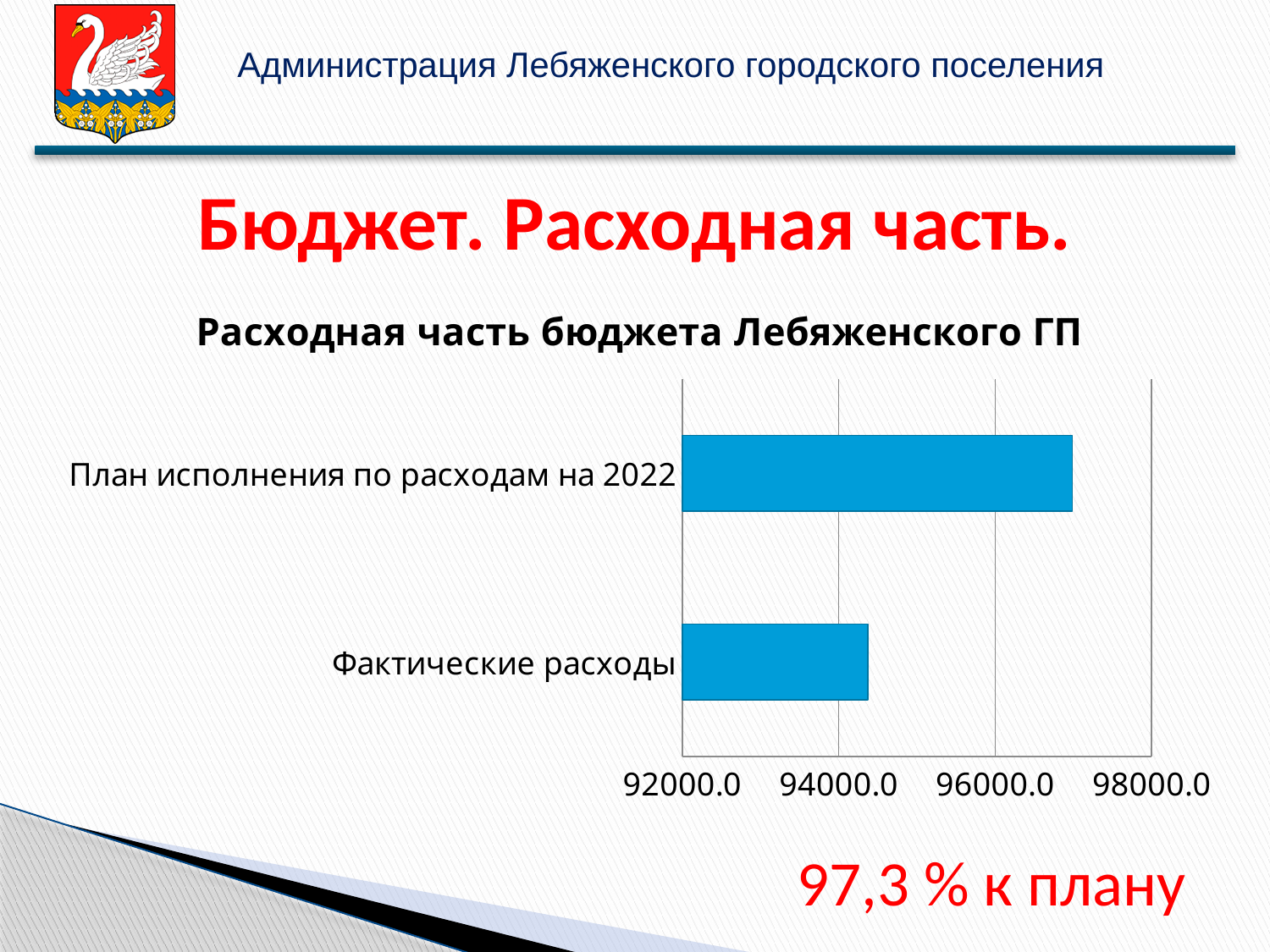
Is the value for Фактические расходы greater or less than 94000.0? greater What kind of chart is shown on the slide? Bar chart Which category has the lowest value? Фактические расходы Is the value for План исполнения по расходам на 2022 greater or less than 96000.0? greater Is the value for План исполнения по расходам на 2022 greater or less than 98000.0? less What is the title of the chart? Расходная часть бюджета Лебяженского ГП How many categories (bars) does the chart show? 2 What is the lowest value shown on the chart's horizontal axis? 92000.0 Which category has the highest value? План исполнения по расходам на 2022 Which is larger: the value for План исполнения по расходам на 2022 or the value for Фактические расходы? План исполнения по расходам на 2022